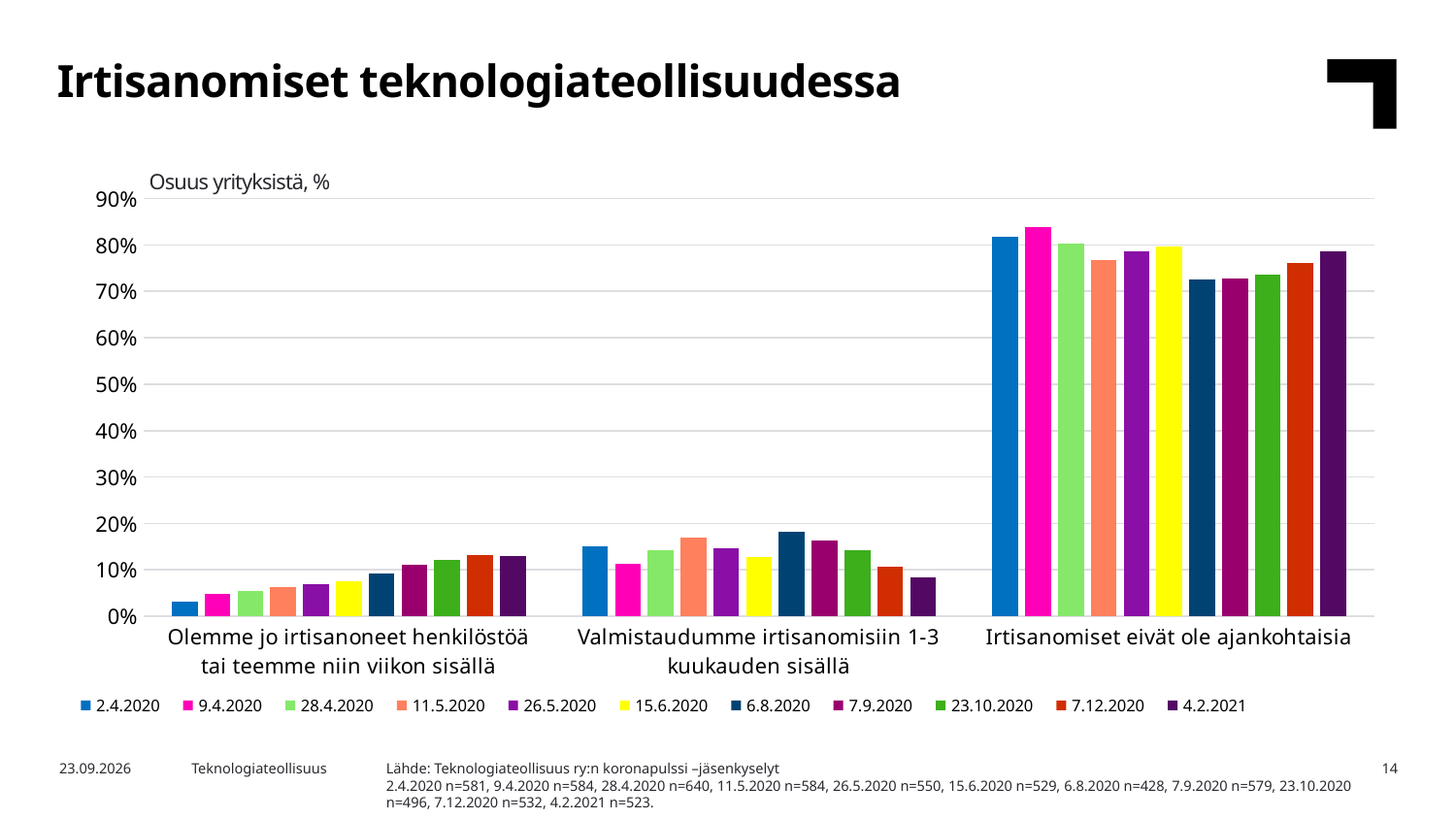
Is the value for 6.8.2020 in the category 'Irtisanomiset eivät ole ajankohtaisia' greater or less than 80%? less How many series does the legend list? 11 Which survey date has the highest value in the category 'Valmistaudumme irtisanomisiin 1-3 kuukauden sisällä'? 6.8.2020 Is the value for 9.4.2020 in the category 'Irtisanomiset eivät ole ajankohtaisia' greater or less than 80%? greater In the category 'Olemme jo irtisanoneet henkilöstöä tai teemme niin viikon sisällä', which is larger: the value for 2.4.2020 or the value for 4.2.2021? 4.2.2021 How many categories are shown on the x axis of the chart? 3 What kind of chart is shown on the slide? bar chart Which survey date has the lowest value in the category 'Olemme jo irtisanoneet henkilöstöä tai teemme niin viikon sisällä'? 2.4.2020 Is the value for 2.4.2020 in the category 'Olemme jo irtisanoneet henkilöstöä tai teemme niin viikon sisällä' greater or less than 10%? less What is the title of the slide's chart? Irtisanomiset teknologiateollisuudessa Which category has the highest values across all survey dates? Irtisanomiset eivät ole ajankohtaisia What label is shown above the y axis of the chart? Osuus yrityksistä, %